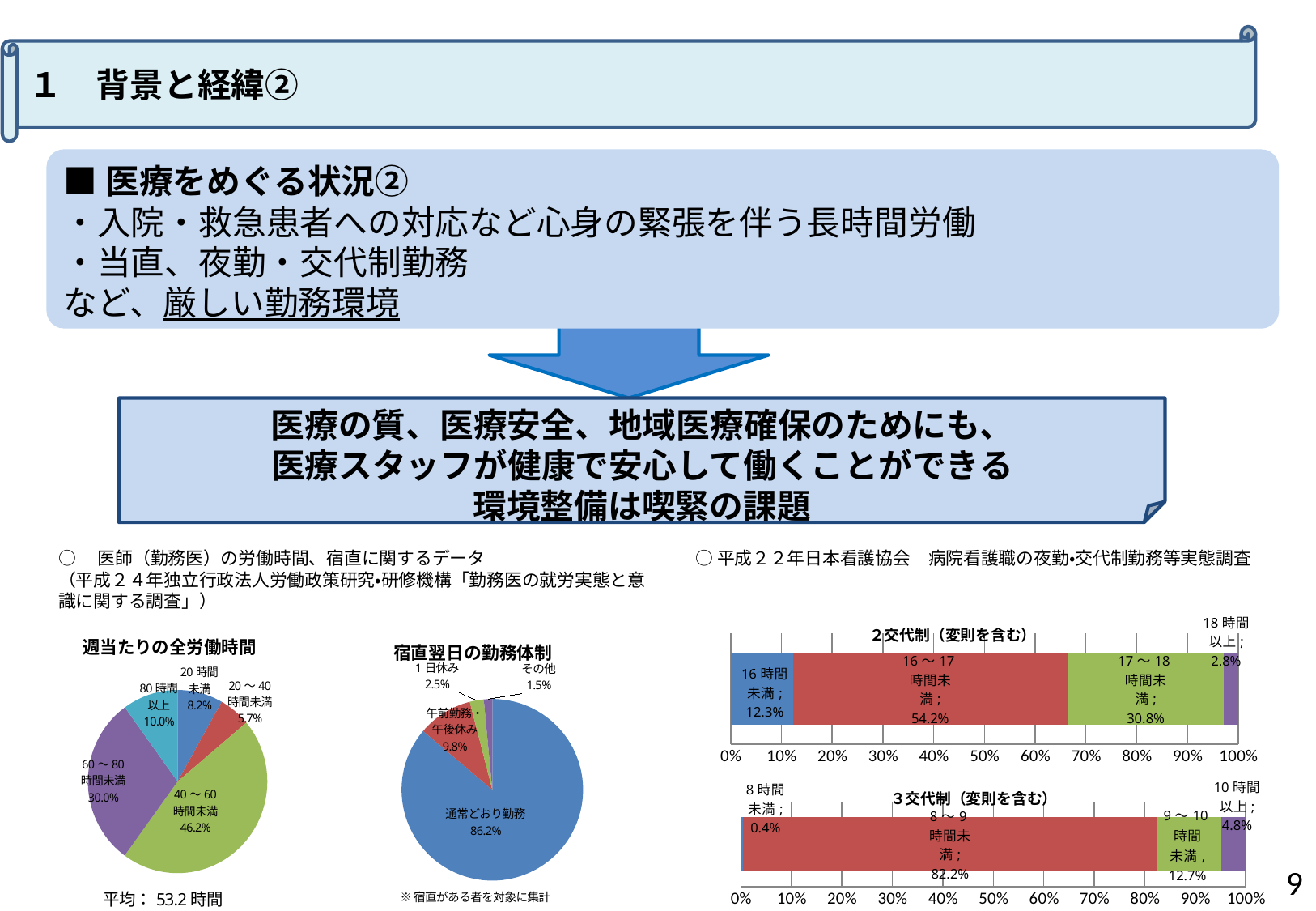
What average value (平均) is printed below the pie chart titled 週当たりの全労働時間? 53.2時間 In the bar chart titled 3交代制（変則を含む）, which segment is the largest? 8～9時間未満 What kind of chart is the one titled 2交代制（変則を含む）? Stacked bar chart In the bar chart titled 3交代制（変則を含む）, what is the difference between the values for 9～10時間未満 and 10時間以上? 7.9% In the pie chart titled 週当たりの全労働時間, which category has the largest share? 40～60時間未満 In the pie chart titled 週当たりの全労働時間, which category has the smallest share? 20～40時間未満 In the pie chart titled 週当たりの全労働時間, what share is labelled for 40～60時間未満? 46.2% In the pie chart titled 宿直翌日の勤務体制, which is larger, 1日休み or 午前勤務・午後休み? 午前勤務・午後休み In the pie chart titled 宿直翌日の勤務体制, what share is labelled for 通常どおり勤務? 86.2% In the pie chart titled 週当たりの全労働時間, how many slices are there? 5 In the bar chart titled 2交代制（変則を含む）, what value is labelled for 17～18時間未満? 30.8% In the pie chart titled 週当たりの全労働時間, what is the difference between the shares for 60～80時間未満 and 80時間以上? 20.0%